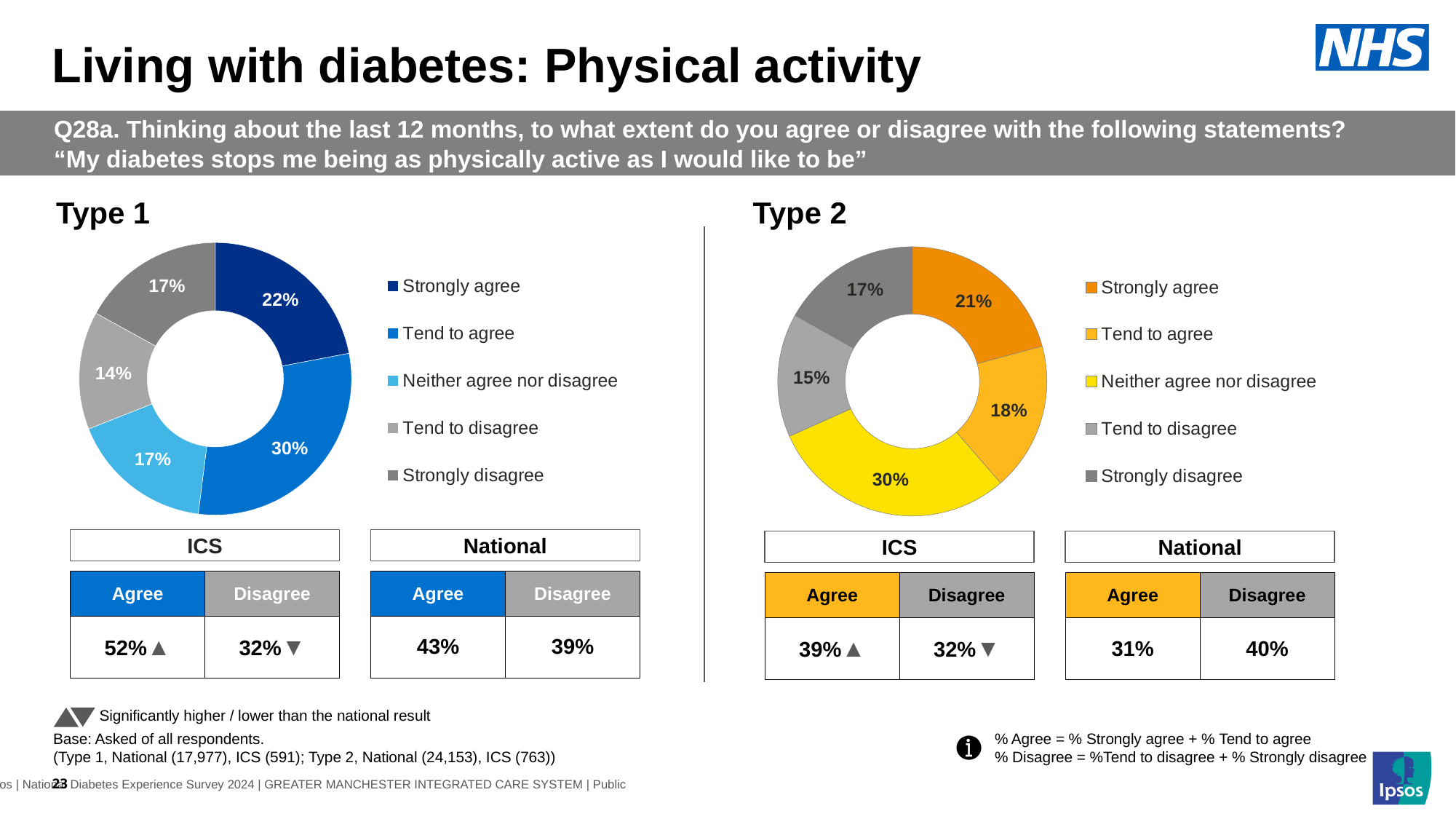
In the Type 2 chart, what percentage of respondents said 'Neither agree nor disagree'? 30% In the Type 2 chart, which is larger: 'Strongly agree' or 'Tend to agree'? Strongly agree In the Type 1 chart, what percentage of respondents said 'Tend to agree'? 30% In the Type 2 chart, which response category has the smallest share? Tend to disagree In the Type 2 chart, what is the combined share of 'Tend to disagree' and 'Strongly disagree'? 32% In the Type 1 chart, what percentage of respondents said 'Tend to disagree'? 14% In the Type 2 chart, what percentage of respondents said 'Strongly agree'? 21% In the Type 1 chart, which response category has the largest share? Tend to agree What kind of chart is used for the Type 2 results? Donut (pie) chart How many response categories does the Type 1 chart's legend list? 5 In the Type 1 chart, what is the difference between the 'Tend to agree' and 'Strongly agree' percentages? 8% In the Type 1 chart, what colour represents 'Strongly agree'? Dark blue